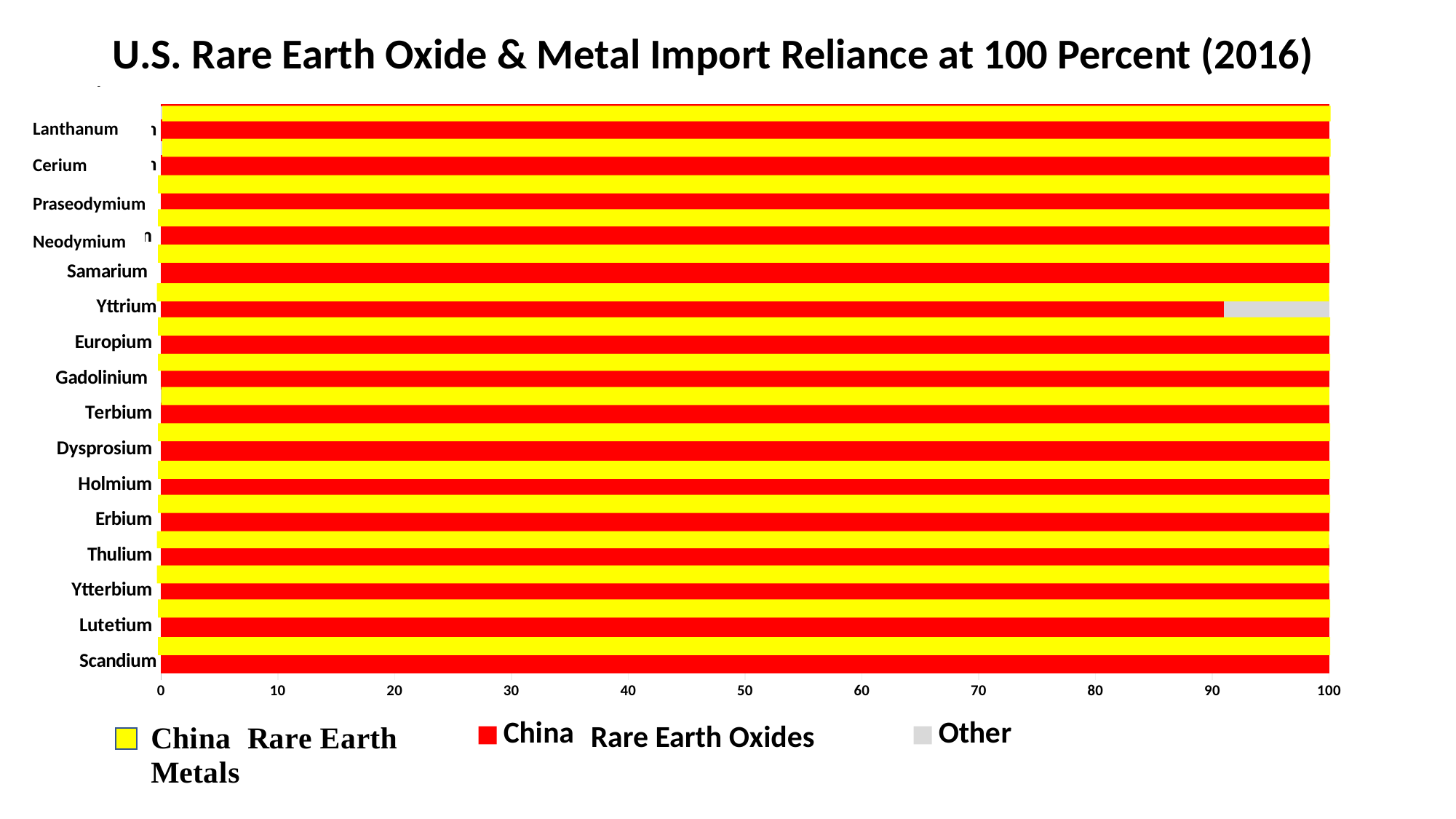
How many series does the legend list? 3 What is the title of the chart? U.S. Rare Earth Oxide & Metal Import Reliance at 100 Percent (2016) Which element is the only one with an 'Other' segment in its bar? Yttrium What kind of chart is shown on the slide? bar chart Which has the larger China Rare Earth Oxides value, Samarium or Yttrium? Samarium Is the China Rare Earth Oxides value for Yttrium greater or less than 95? less What is the China Rare Earth Oxides value for Europium? 100 What is the China Rare Earth Metals value for Scandium? 100 Is the China Rare Earth Oxides value for Yttrium greater or less than 80? greater Which element has the lowest China Rare Earth Oxides value? Yttrium How many rare earth elements are listed as categories on the chart? 16 What is the China Rare Earth Metals value for Lanthanum? 100